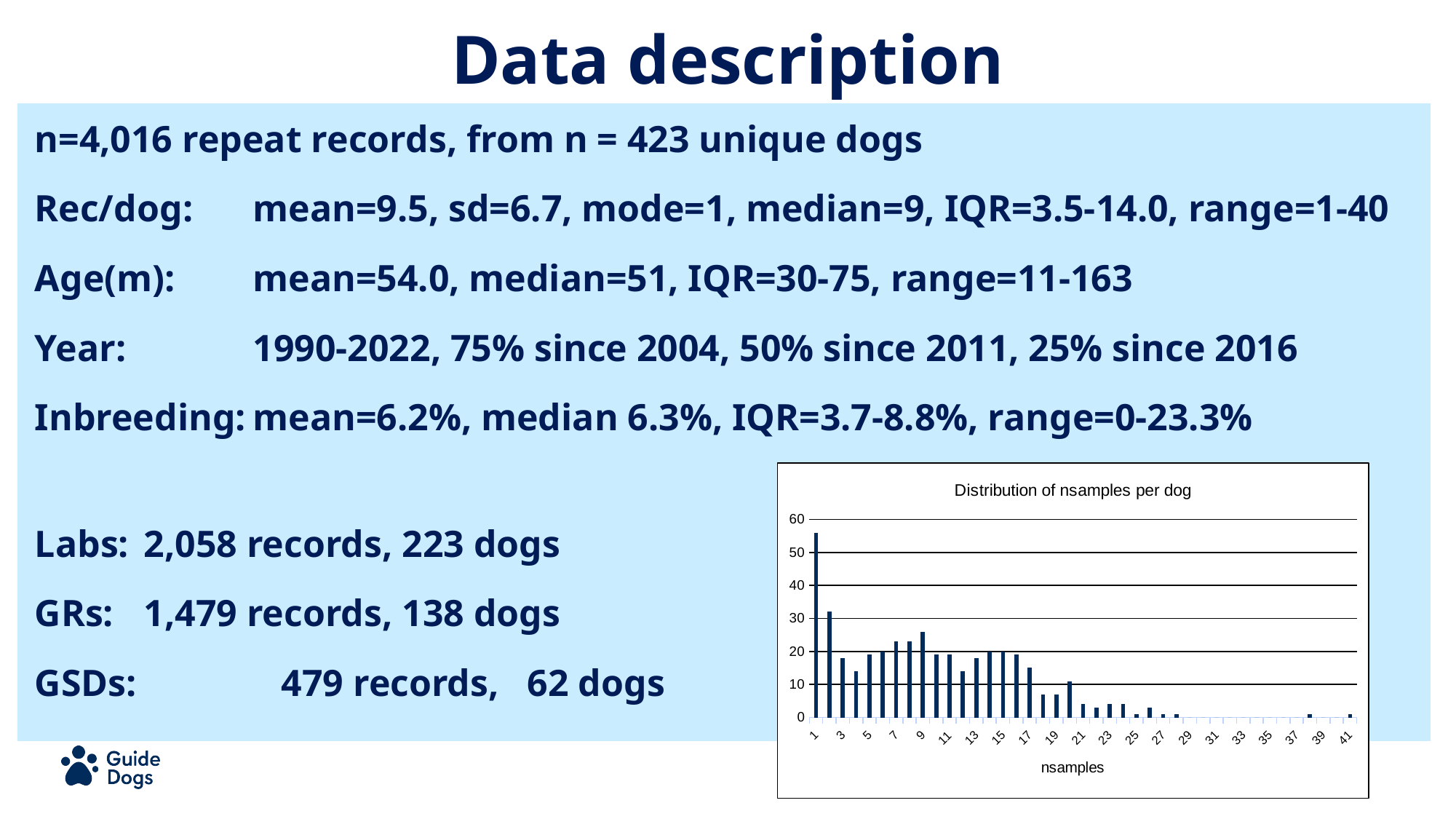
Which nsamples value has the tallest bar in the chart? 1 What is the label of the x axis of the chart? nsamples Is the value for nsamples = 9 greater or less than 20? greater Overall, do the bar heights rise or fall as nsamples increases along the x axis? fall Is the value for nsamples = 1 greater or less than 50? greater Is the value for nsamples = 19 greater or less than 10? less What kind of chart is shown on the slide? bar chart Which is larger, the value for nsamples = 1 or the value for nsamples = 2? nsamples = 1 What is the title of the chart on the slide? Distribution of nsamples per dog